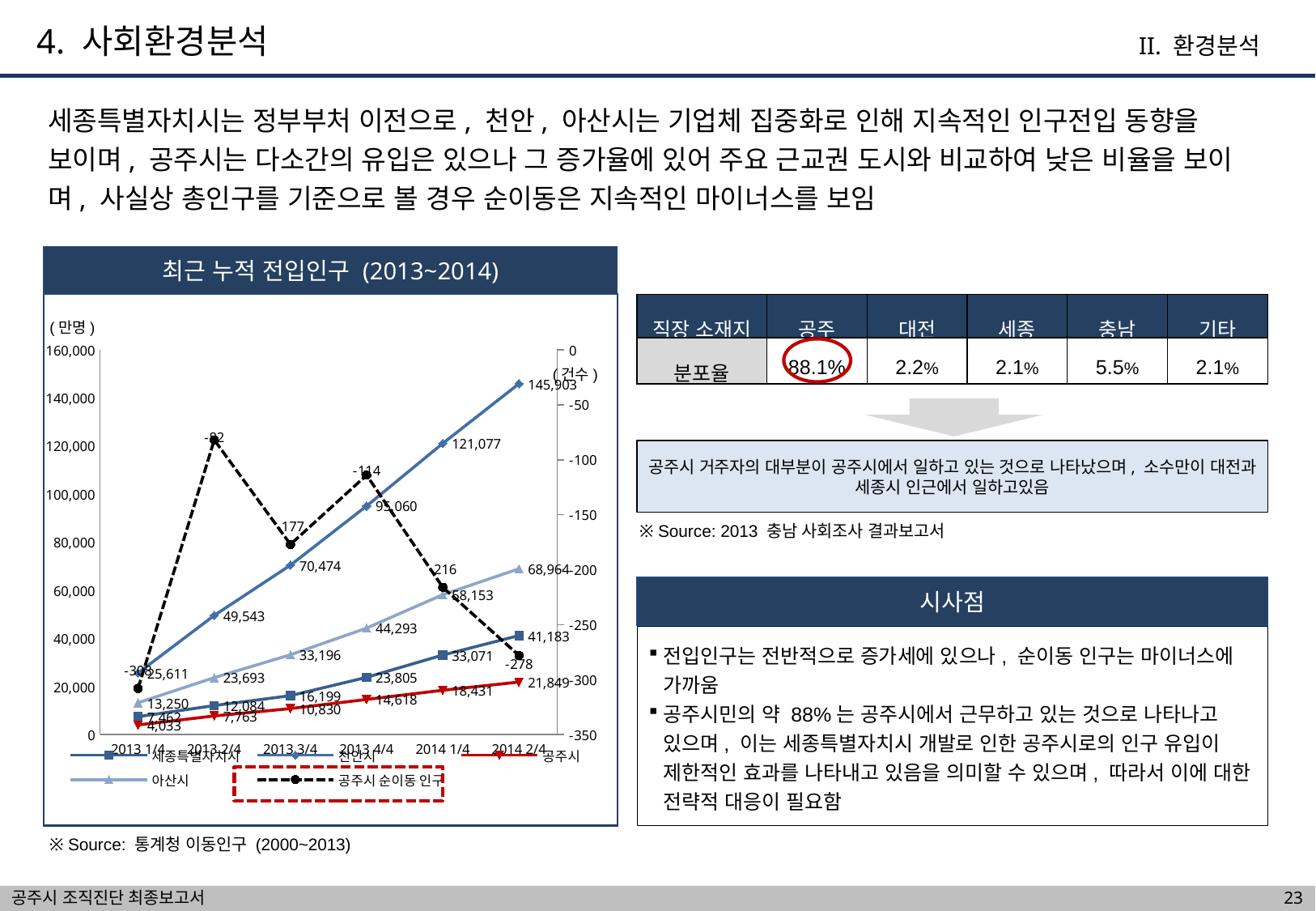
In the '최근 누적 전입인구' chart, which series has the lowest value at 2014 2/4 on the left axis? 공주시 In the '최근 누적 전입인구' chart, does the 공주시 line rise or fall from 2013 1/4 to 2014 2/4? rise In the '최근 누적 전입인구' chart, what is the value for 아산시 at 2014 1/4? 58,153 In the '최근 누적 전입인구' chart, what is the value for 공주시 at 2013 1/4? 4,033 What type of chart is shown under the title '최근 누적 전입인구 (2013~2014)'? line chart How many time points are plotted along the x axis of the '최근 누적 전입인구' chart? 6 In the '최근 누적 전입인구' chart, what is the value of 공주시 순이동 인구 at 2014 2/4? -278 In the '최근 누적 전입인구' chart, what is the value for 세종특별자치시 at 2013 4/4? 23,805 In the '최근 누적 전입인구' chart, which series has the highest value at 2014 2/4? 천안시 In the '최근 누적 전입인구' chart, what is the difference between the 천안시 value and the 아산시 value at 2014 2/4? 76,939 How many series does the legend of the '최근 누적 전입인구' chart list? 5 In the '최근 누적 전입인구' chart, what is the value for 천안시 at 2014 2/4? 145,903